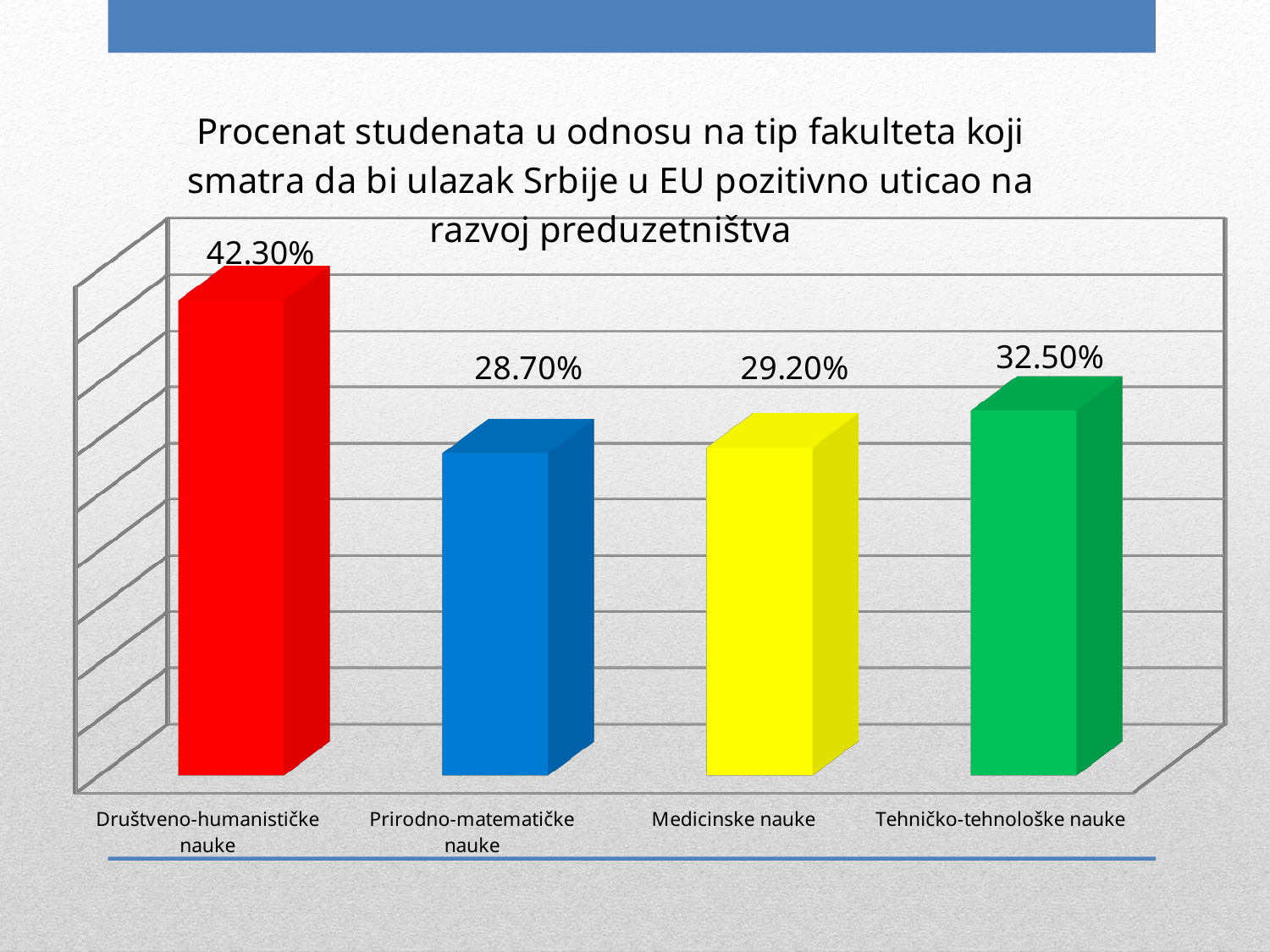
How many faculty types are shown on the chart? 4 Which faculty type has the highest percentage? Društveno-humanističke nauke What kind of chart is shown on the slide? Bar chart What is the difference between the values for Društveno-humanističke nauke and Tehničko-tehnološke nauke? 9.80% Which faculty type has the lowest percentage? Prirodno-matematičke nauke Which is larger, the value for Tehničko-tehnološke nauke or the value for Medicinske nauke? Tehničko-tehnološke nauke What is the value for Društveno-humanističke nauke? 42.30% What is the difference between the values for Medicinske nauke and Prirodno-matematičke nauke? 0.50% What is the value for Tehničko-tehnološke nauke? 32.50% What colour is the bar for Medicinske nauke? Yellow What is the value for Medicinske nauke? 29.20% What is the value for Prirodno-matematičke nauke? 28.70%